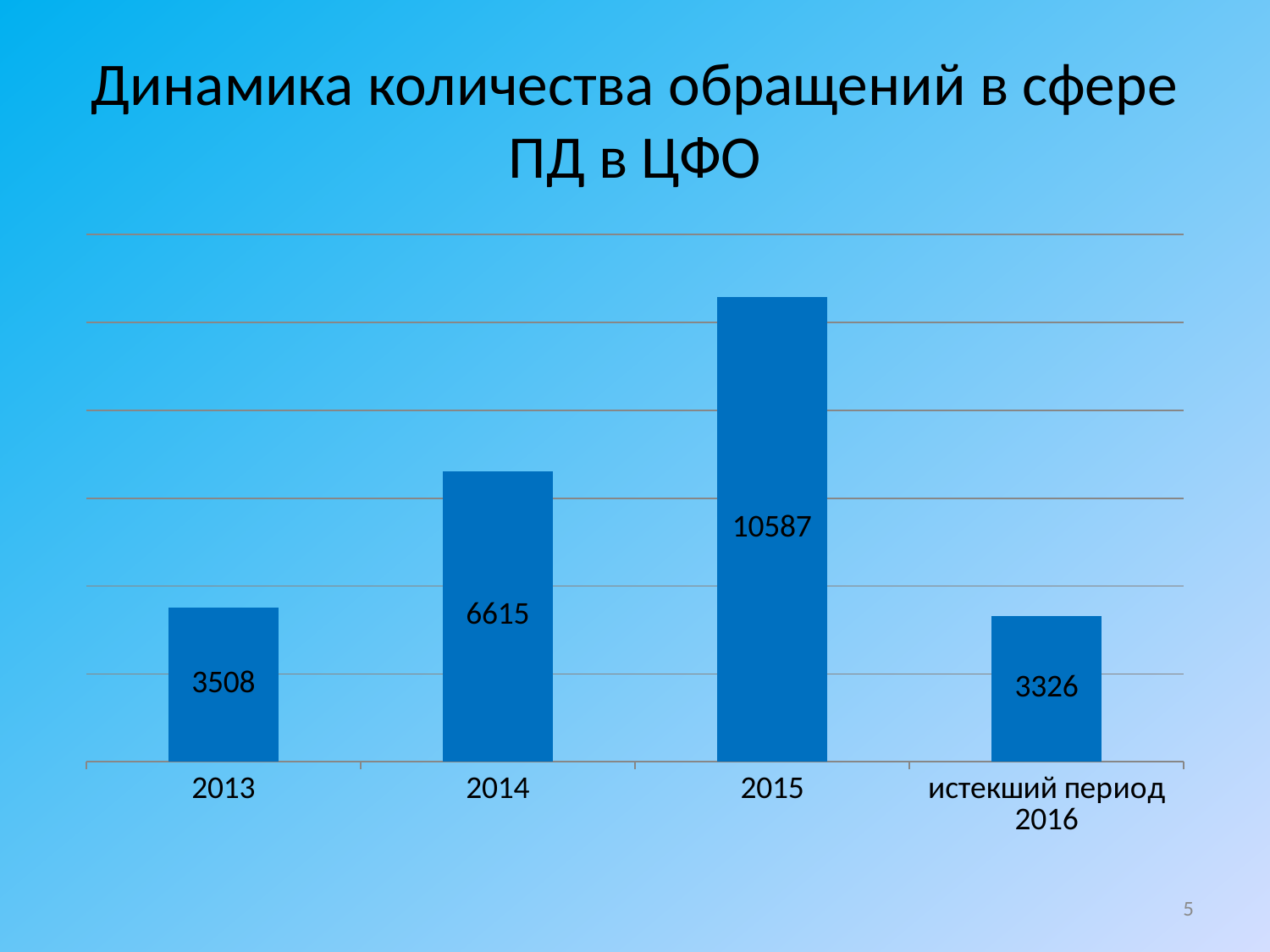
Which is larger, the value for 2014 or the value for 2013? 2014 What is the value for 2013? 3508 What is the value for 2015? 10587 What kind of chart is shown on the slide? bar chart What is the difference between the values for 2013 and истекший период 2016? 182 Which category has the highest value? 2015 What is the value for истекший период 2016? 3326 What is the difference between the values for 2015 and 2014? 3972 Which category has the lowest value? истекший период 2016 What is the value for 2014? 6615 What is the title of the chart? Динамика количества обращений в сфере ПД в ЦФО How many categories are shown on the x axis? 4